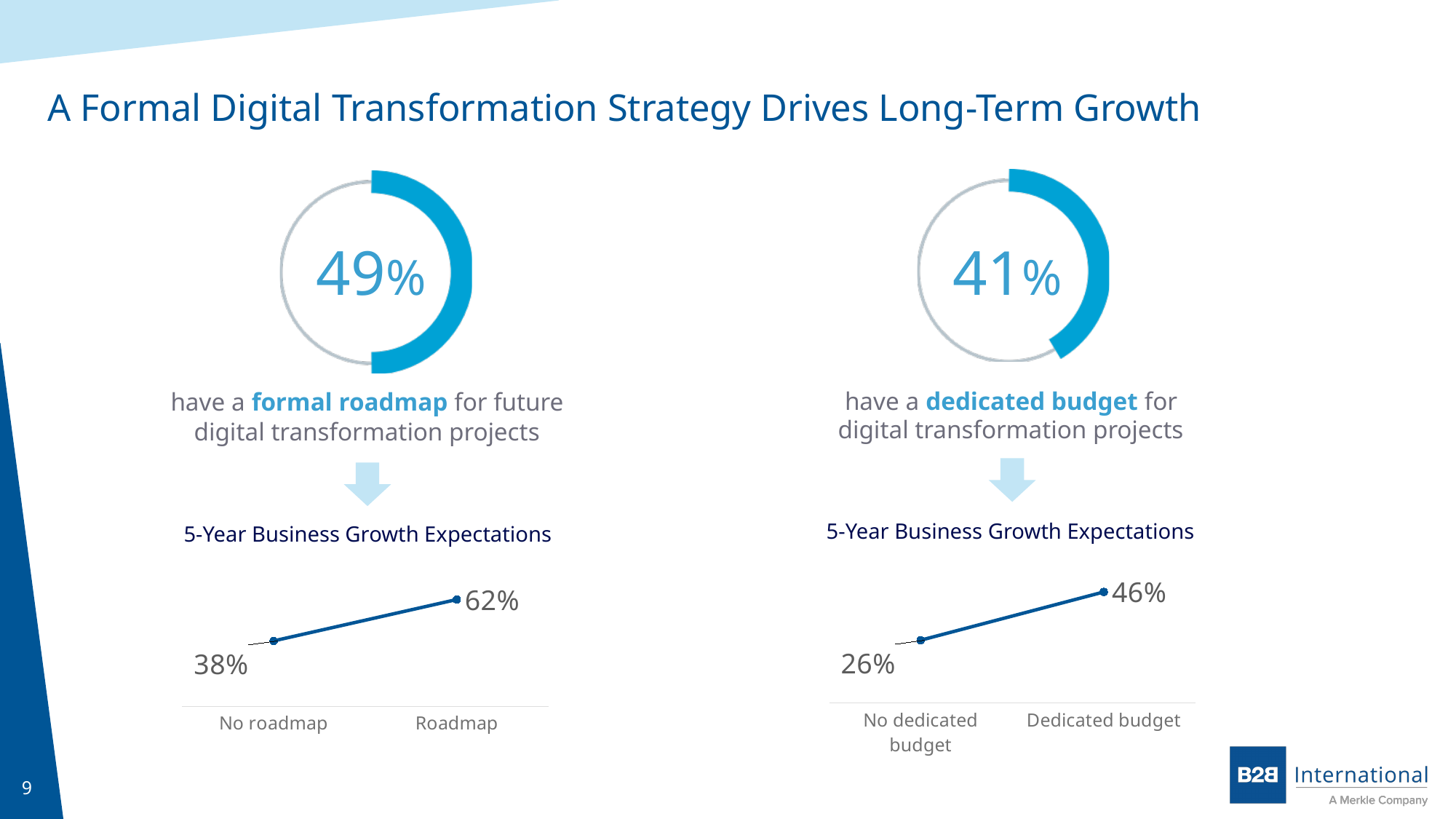
In the left line chart (5-Year Business Growth Expectations, under the formal roadmap donut), what is the value for Roadmap? 62% In the left line chart, which category has the higher value, No roadmap or Roadmap? Roadmap In the right line chart, do the values rise or fall from No dedicated budget to Dedicated budget? rise In the right line chart, which category has the lowest value? No dedicated budget In the right line chart (5-Year Business Growth Expectations, under the dedicated budget donut), what is the value for No dedicated budget? 26% What kind of chart is used for the 5-Year Business Growth Expectations on the left? line chart In the right line chart, what is the difference between the Dedicated budget and No dedicated budget values? 20 percentage points How many categories are plotted in the left line chart? 2 What percentage is shown in the left donut chart for companies that have a formal roadmap for future digital transformation projects? 49% In the left line chart, what is the difference between the Roadmap and No roadmap values? 24 percentage points In the left line chart (5-Year Business Growth Expectations, under the formal roadmap donut), what is the value for No roadmap? 38% In the right line chart (5-Year Business Growth Expectations, under the dedicated budget donut), what is the value for Dedicated budget? 46%